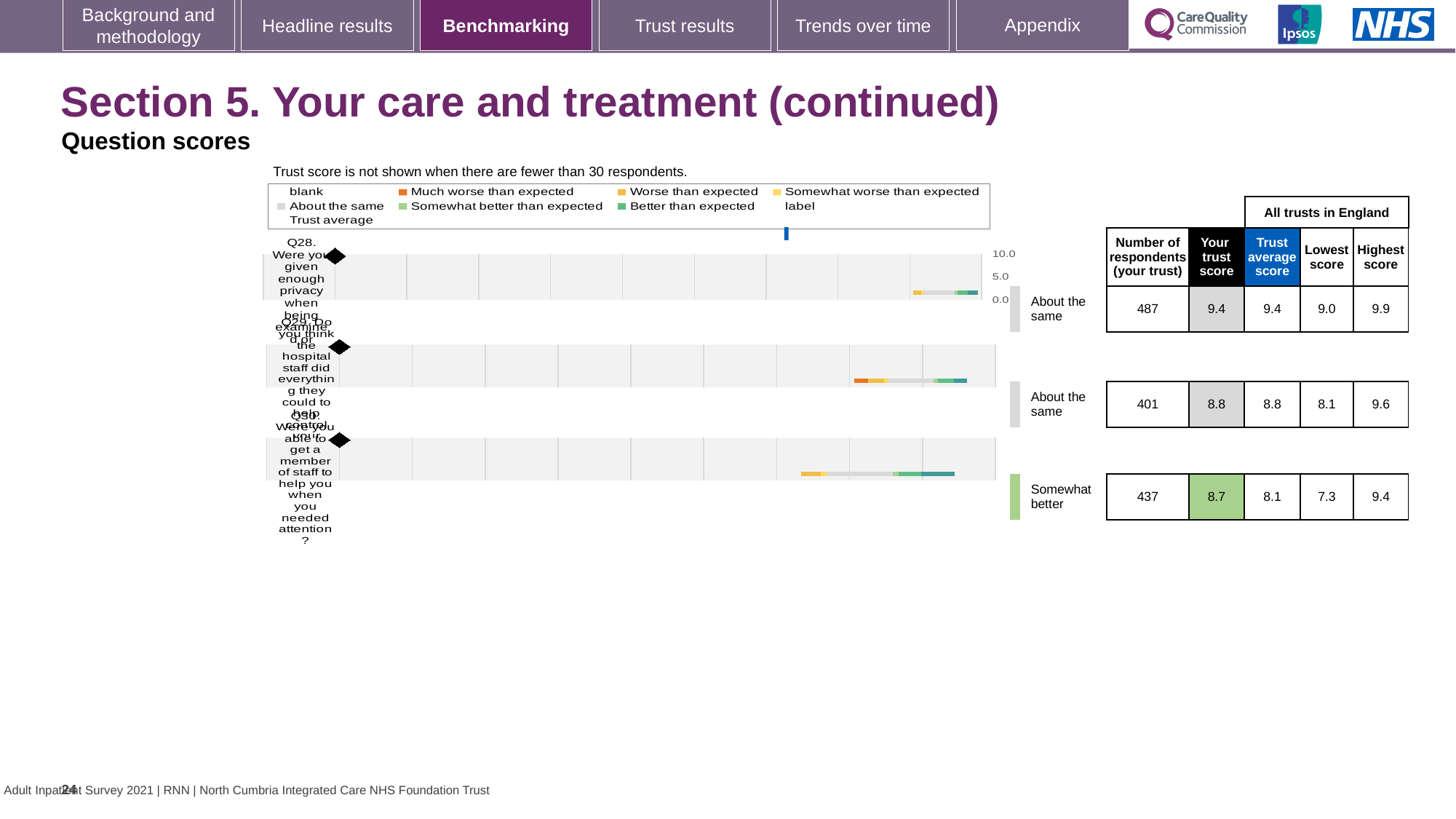
Which question has the lowest trust score on this slide? Q30 How many questions are plotted on this slide? 3 How many respondents answered Q30? 437 What is the difference between the trust score for Q28 and the trust score for Q30? 0.7 What benchmark category is shown for Q30? Somewhat better What is the highest score across all trusts in England for Q29? 9.6 What is the trust score for Q29 (staff did everything to help control pain)? 8.8 What is the trust score for Q28 (privacy when being examined or treated)? 9.4 What is the lowest score across all trusts in England for Q30? 7.3 Which question has the highest trust score on this slide? Q28 Is the trust score for Q29 greater or less than 5.0? greater What is the trust score for Q30 (able to get a member of staff to help when needed)? 8.7